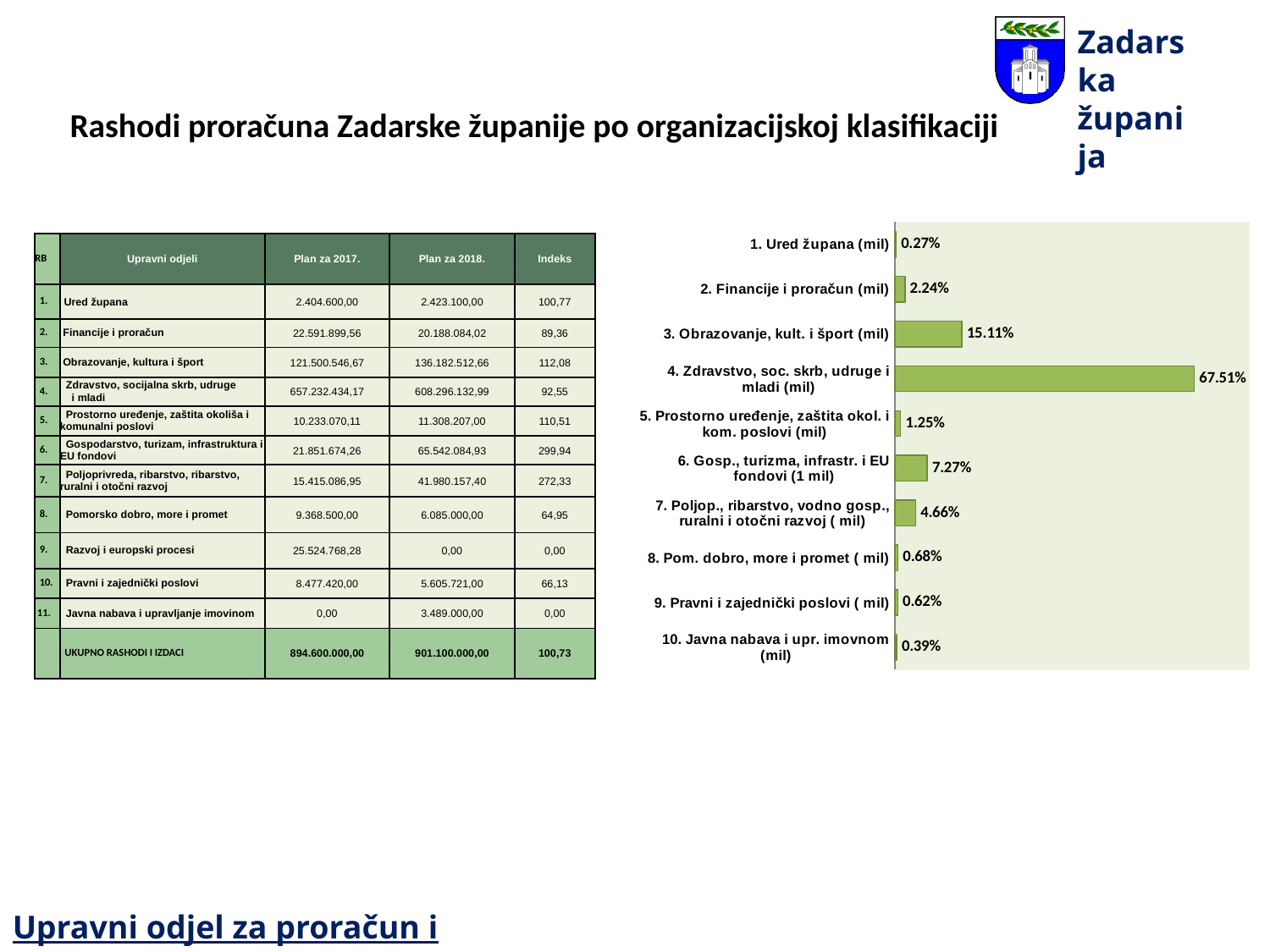
What is the difference between the values for "4. Zdravstvo, soc. skrb, udruge i mladi (mil)" and "3. Obrazovanje, kult. i šport (mil)"? 52.40% How many categories are shown in the chart? 10 What kind of chart is shown on the slide? Bar chart What is the difference between the values for "6. Gosp., turizma, infrastr. i EU fondovi (1 mil)" and "7. Poljop., ribarstvo, vodno gosp., ruralni i otočni razvoj (mil)"? 2.61% Which category has the lowest value in the chart? 1. Ured župana (mil) What is the value shown for "3. Obrazovanje, kult. i šport (mil)"? 15.11% Which category has the highest value in the chart? 4. Zdravstvo, soc. skrb, udruge i mladi (mil) What is the value shown for "10. Javna nabava i upr. imovnom (mil)"? 0.39% What is the value shown for "6. Gosp., turizma, infrastr. i EU fondovi (1 mil)"? 7.27% Which has a larger value: "2. Financije i proračun (mil)" or "5. Prostorno uređenje, zaštita okol. i kom. poslovi (mil)"? 2. Financije i proračun (mil) What is the value shown for "4. Zdravstvo, soc. skrb, udruge i mladi (mil)"? 67.51% What is the value shown for "1. Ured župana (mil)"? 0.27%